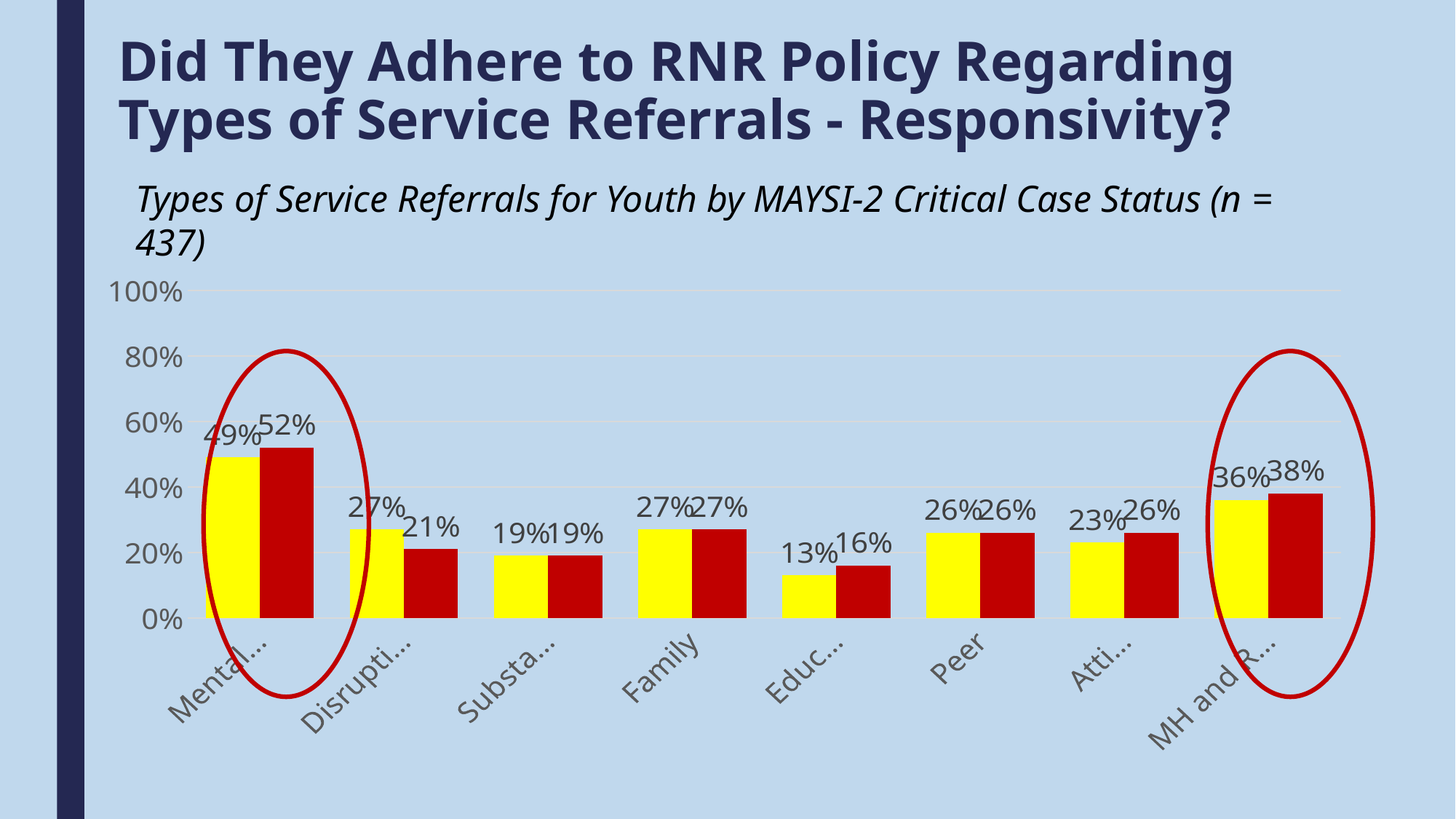
Is the value of the red bar for Family greater or less than 20%? greater What is the highest value labelled on the chart? 52% What is the difference between the red bar and the yellow bar in the rightmost category? 2 percentage points What is the value of the red bar for Peer? 26% Which has the larger yellow bar, Family or Peer? Family How many categories are shown along the x axis of the chart? 8 What kind of chart is shown on the slide? Bar chart What is the lowest value labelled on the chart? 13% What is the value of the yellow bar for Family? 27% What two colours are used for the bars in the chart? Yellow and red What is the title of the chart? Types of Service Referrals for Youth by MAYSI-2 Critical Case Status (n = 437) What is the difference between the red bar and the yellow bar in the leftmost category? 3 percentage points